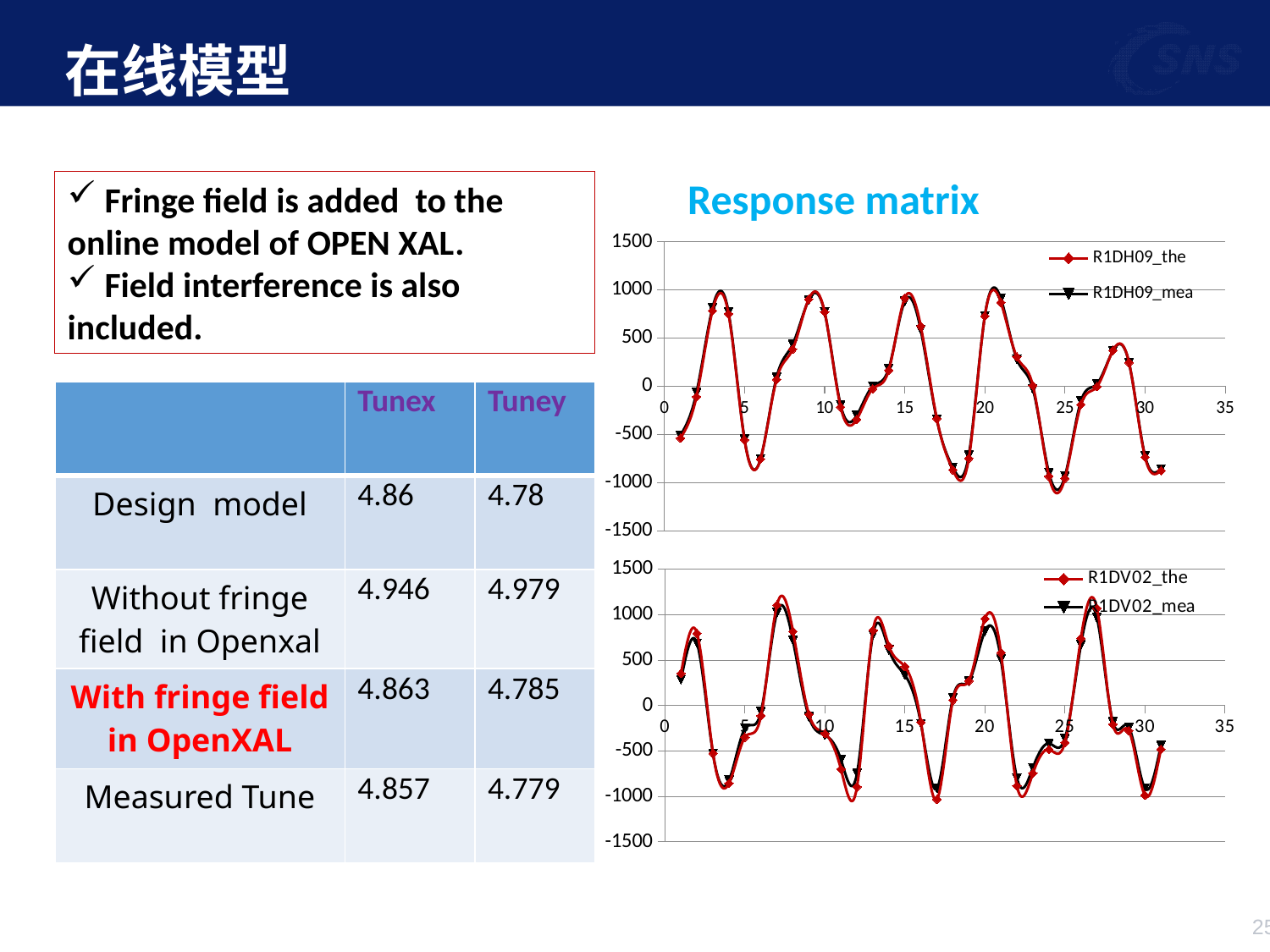
In the top chart, is the value of R1DH09_the at x = 2 greater or less than 500? less In the bottom chart, is the lowest value of the R1DV02_mea series greater or less than -500? less In the top chart, is the highest value of the R1DH09_the series greater or less than 500? greater How many series does the legend of the bottom chart list? 2 What kind of chart is the bottom chart on the slide? line chart What kind of chart is the top chart on the slide? line chart What is the title shown above the charts on the right side of the slide? Response matrix In the bottom chart, which series is drawn in red? R1DV02_the How many series does the legend of the top chart list? 2